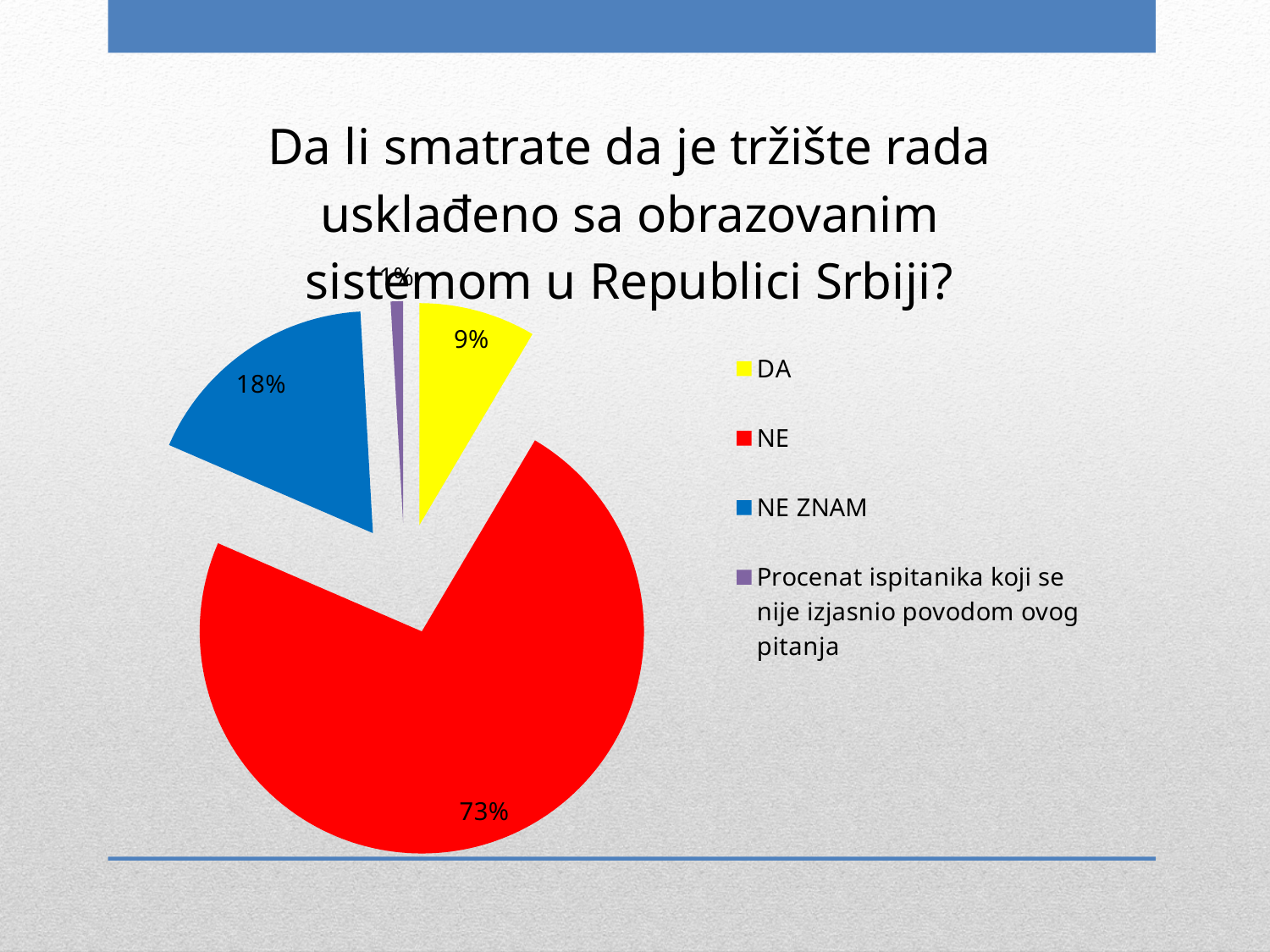
What percentage of respondents answered DA? 9% What percentage of respondents answered NE ZNAM? 18% What is the difference in percentage points between the NE and NE ZNAM slices? 55 Which answer has the smallest share of the pie? Procenat ispitanika koji se nije izjasnio povodom ovog pitanja Which slice is larger, DA or NE ZNAM? NE ZNAM How many slices does the pie chart have? 4 What colour is the NE slice? red Which answer has the largest share of the pie? NE What is the difference in percentage points between the NE ZNAM and DA slices? 9 What percentage of respondents answered NE? 73% How many entries does the legend list? 4 What kind of chart is shown on the slide? pie chart